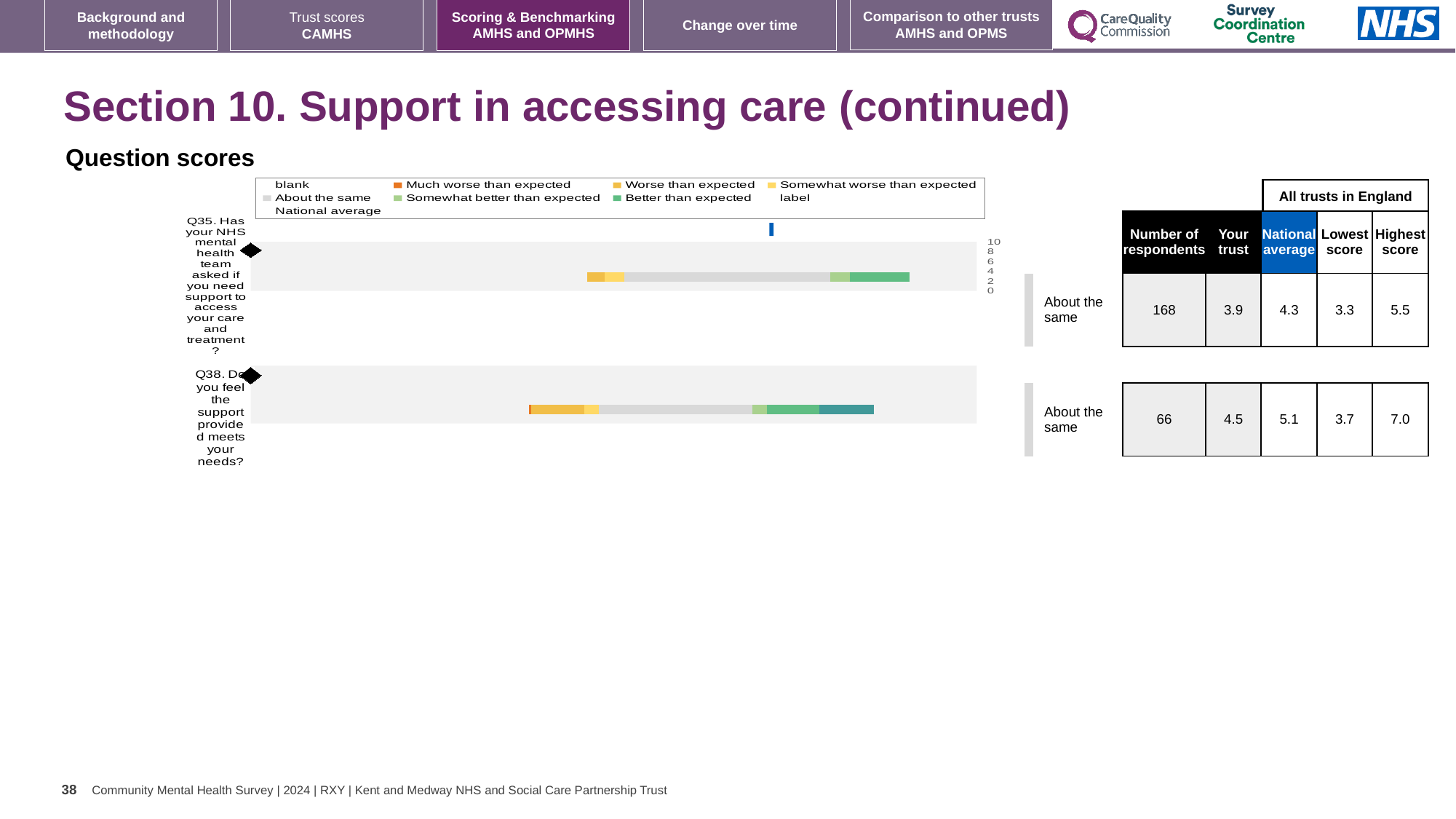
What benchmark category is given for Q35 and Q38 next to the chart? About the same What is the 'Your trust' score for Q35 in the table next to the chart? 3.9 What is the highest value shown on the chart's numeric axis? 10 Which question has the higher 'Your trust' score, Q35 or Q38? Q38 What kind of chart is shown on the slide? bar chart What is the difference between the national average and the 'Your trust' score for Q35? 0.4 How many questions (bars) are plotted in the chart? 2 What is the national average for Q38 in the table next to the chart? 5.1 How many respondents answered Q35 according to the table? 168 What is the highest score across all trusts in England for Q38? 7.0 What is the 'Your trust' score for Q38 in the table next to the chart? 4.5 Which legend entry is shown in orange? Much worse than expected